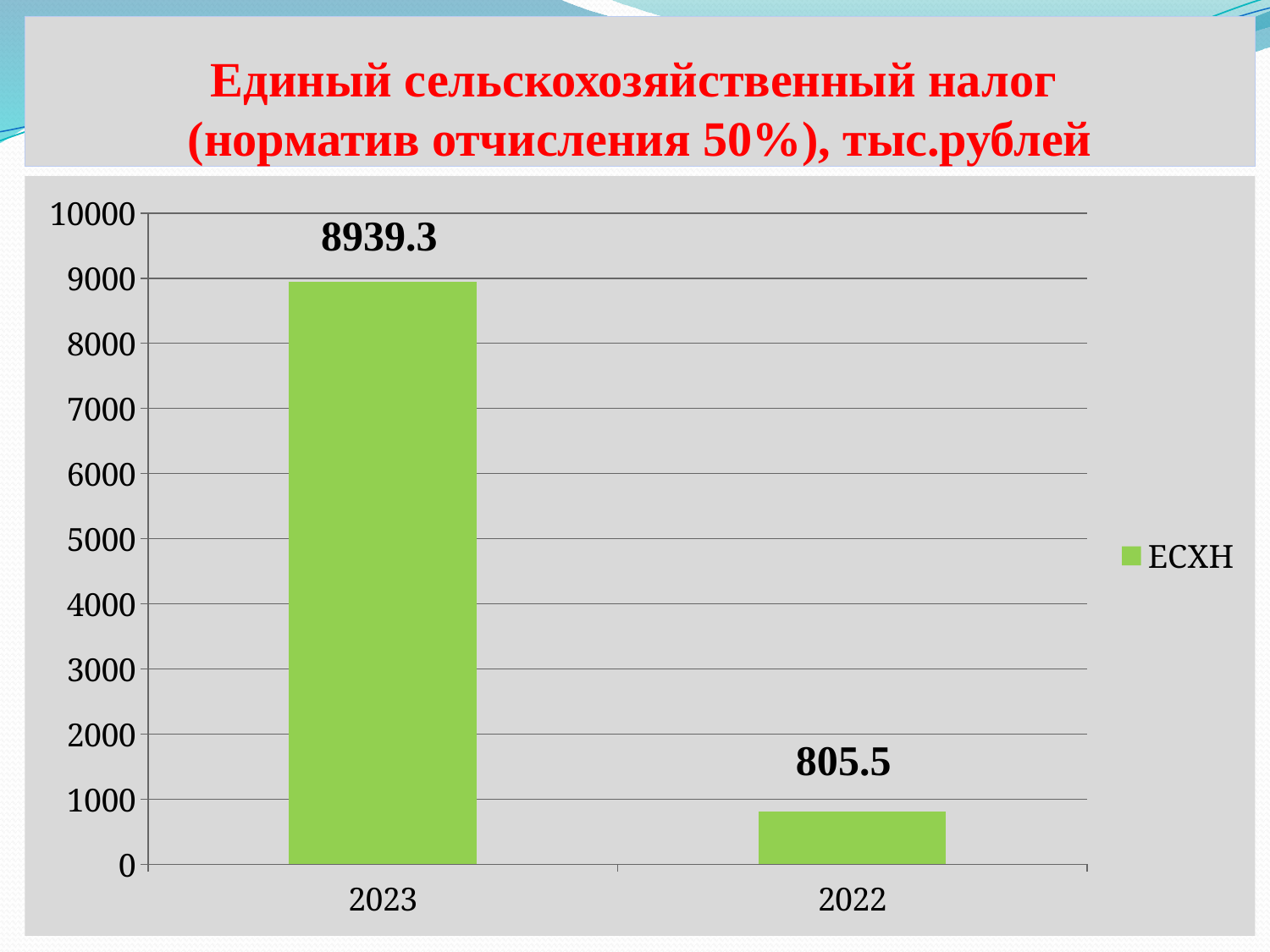
What is the value for 2022? 805.5 What is the value for 2023? 8939.3 What series name is shown in the legend? ЕСХН How many categories are shown on the x axis? 2 Which year has the lowest value? 2022 What kind of chart is shown on the slide? bar chart How many series does the legend list? 1 What is the difference between the values for 2023 and 2022? 8133.8 Is the value for 2023 greater or less than 8000? greater Which year has the highest value? 2023 Is the value for 2022 greater or less than 1000? less Which is larger, the value for 2023 or the value for 2022? 2023